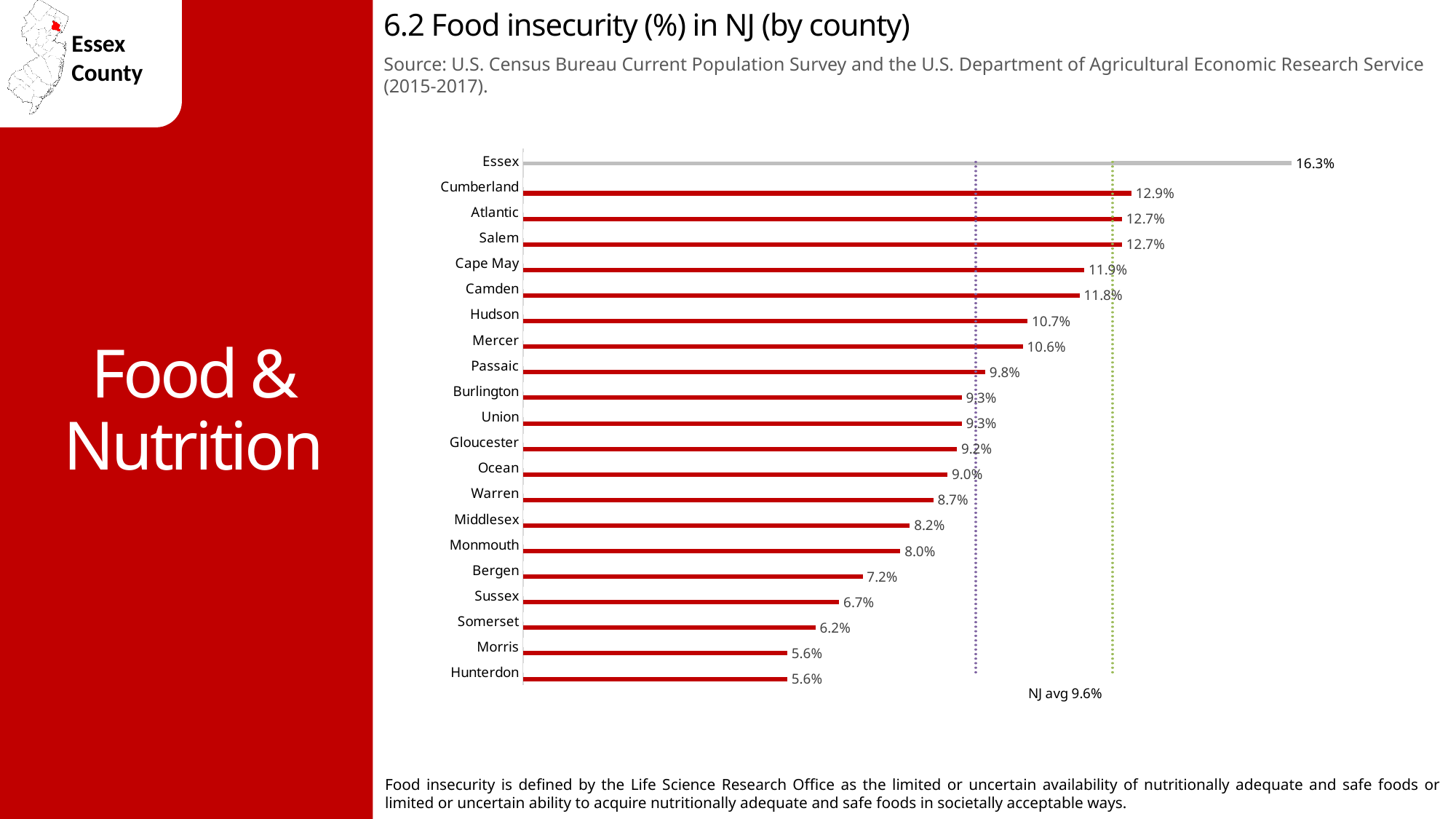
What NJ average food insecurity rate is noted on the chart? 9.6% Which county has a higher food insecurity rate, Monmouth or Warren? Warren What is the food insecurity rate for Hudson County? 10.7% What is the food insecurity rate for Essex County? 16.3% What is the food insecurity rate for Cumberland County? 12.9% What is the difference between the food insecurity rates of Passaic and Somerset counties? 3.6% Which county has the highest food insecurity rate? Essex What is the food insecurity rate for Bergen County? 7.2% What is the difference between the food insecurity rates of Essex and Cumberland counties? 3.4% Which county has a higher food insecurity rate, Camden or Mercer? Camden How many counties are shown in the chart? 21 What type of chart is used to show food insecurity by county? Bar chart